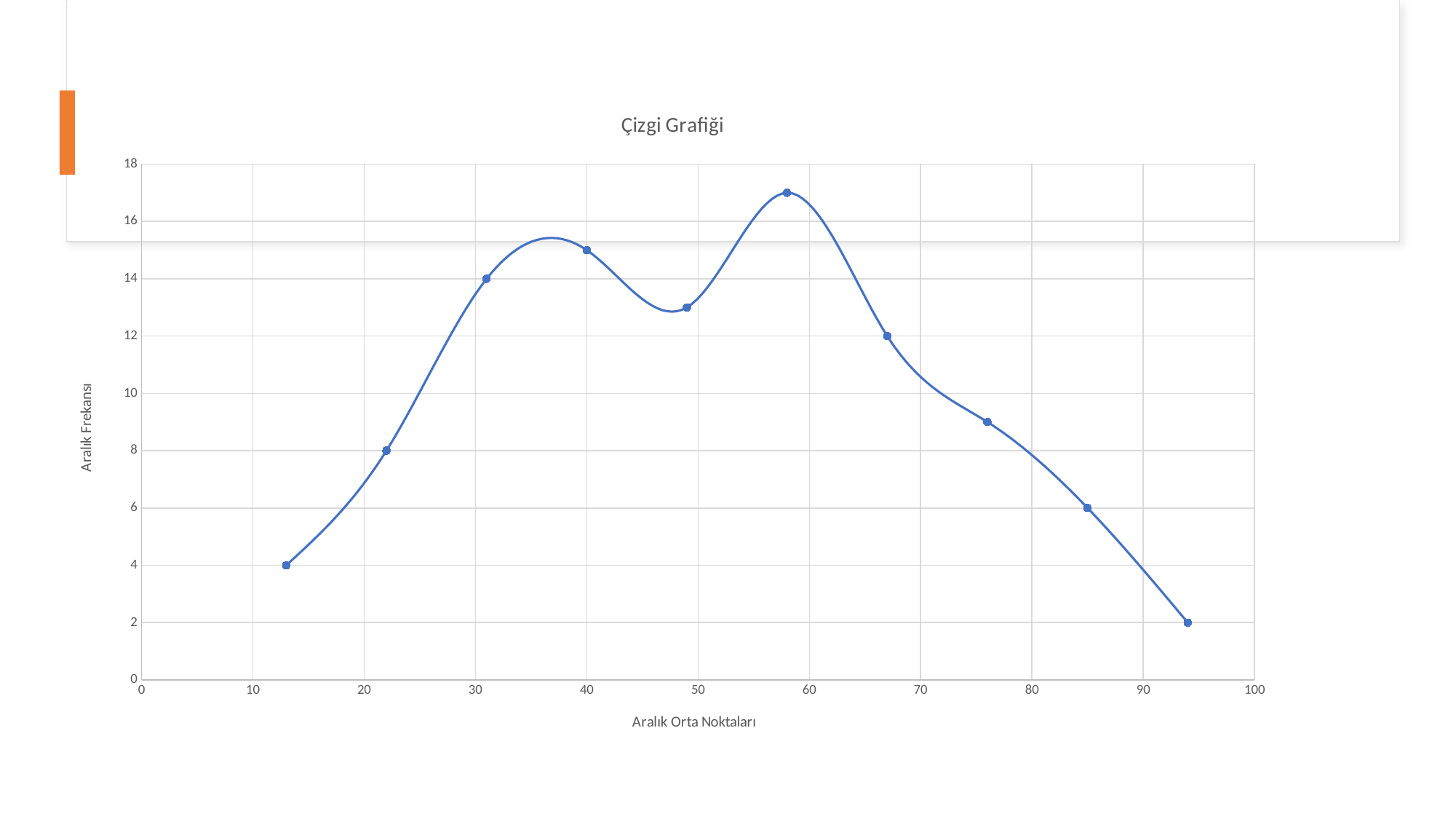
Which is larger, the value of the first data point or the value of the last data point? the first data point Is the value of the highest data point greater or less than 16? greater What is the title of the chart? Çizgi Grafiği What is the label of the vertical axis? Aralık Frekansı How many data points are plotted on the line? 10 What is the value of the first (leftmost) data point? 4 Which data point has the lowest value? the last (rightmost) point Does the line rise or fall between the seventh data point and the last data point? fall What is the value of the last (rightmost) data point? 2 What kind of chart is shown on the slide? line chart Is the value of the fourth data point from the left greater or less than 14? greater What is the value of the second data point from the left? 8